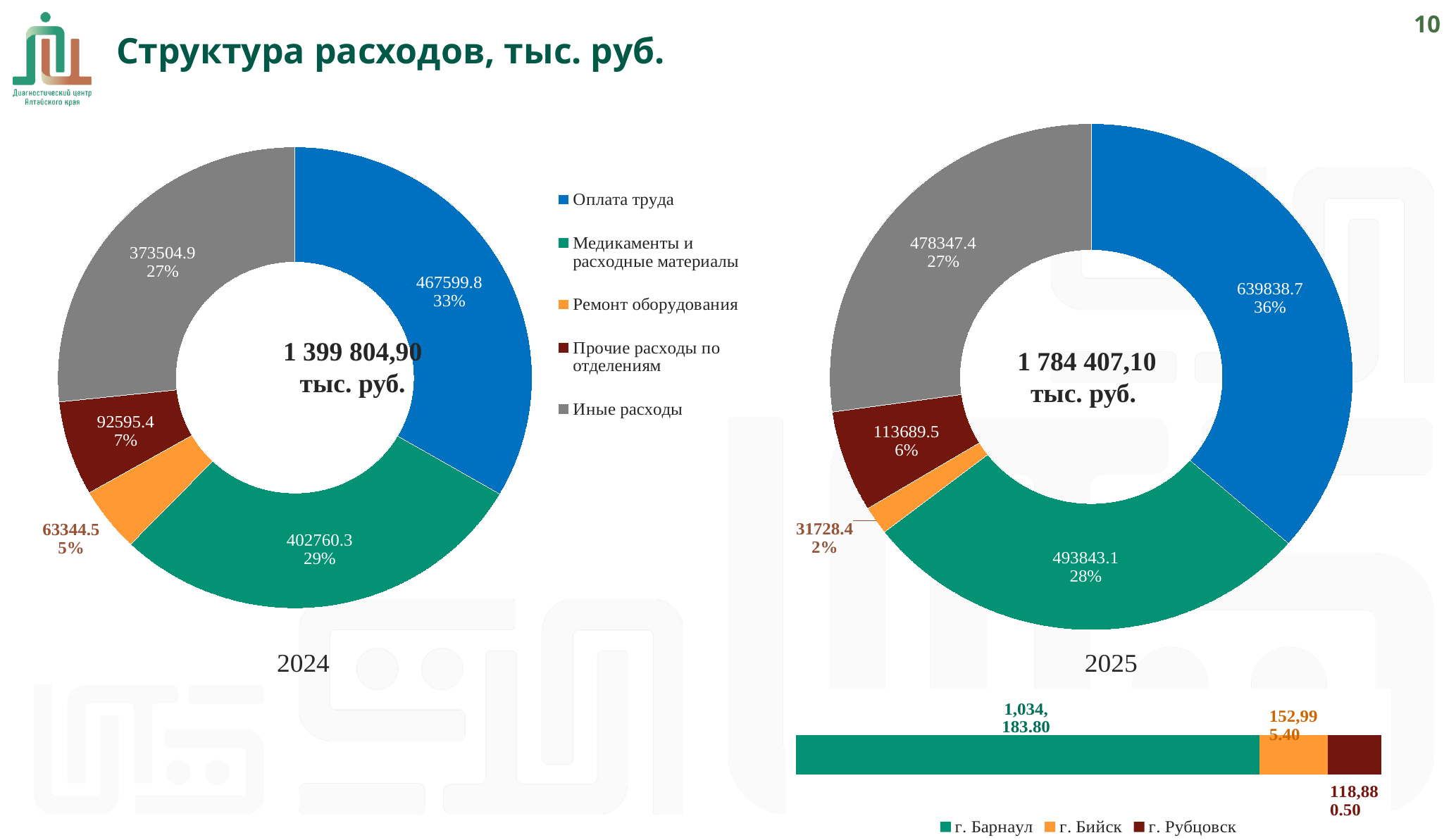
What total is shown in the centre of the 2025 donut chart? 1 784 407,10 тыс. руб. How many categories does the legend of the donut charts list? 5 What is the difference between the Оплата труда values in the 2025 and 2024 donut charts? 172238.9 In the stacked bar chart at the bottom right, what is the value for г. Бийск? 152,995.40 In the 2025 donut chart, which category has the largest value? Оплата труда In the 2024 donut chart, what is the value for Оплата труда? 467599.8 What type of chart is shown at the bottom right of the slide? Stacked bar chart In the 2024 donut chart, which category has the smallest value? Ремонт оборудования In the 2025 donut chart, what is the value for Медикаменты и расходные материалы? 493843.1 In the 2025 donut chart, what share of expenses is Ремонт оборудования? 2% In the stacked bar chart at the bottom right, which city has the smallest value? г. Рубцовск Which is larger: Иные расходы in 2024 or Прочие расходы по отделениям in 2024? Иные расходы in 2024